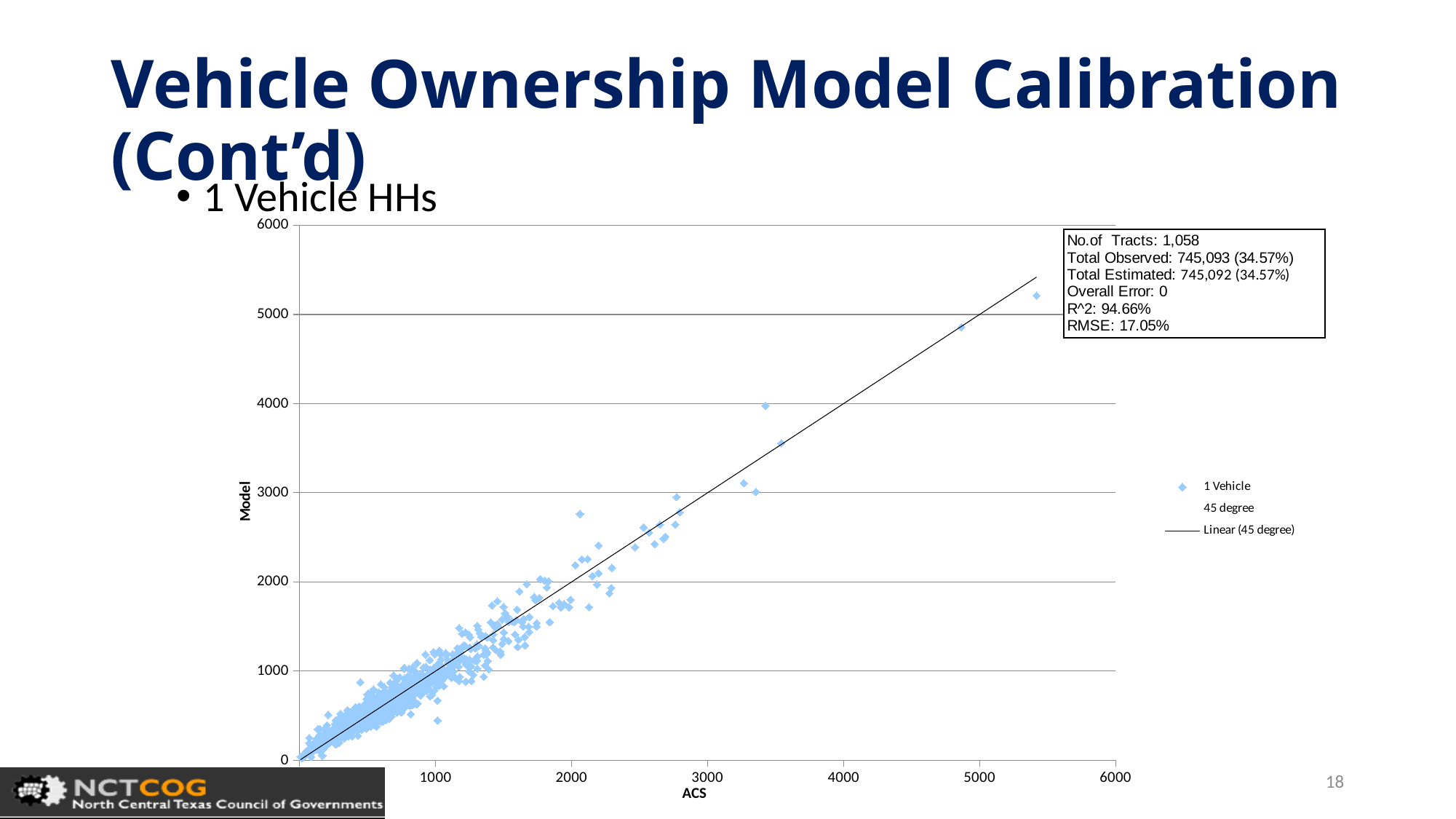
What Overall Error is reported in the chart's text box? 0 Is the Model value of the highest plotted point greater or less than 5000? greater Do the Model values generally rise or fall as the ACS values increase along the x axis? rise According to the text box on the chart, what is the Total Observed value? 745,093 (34.57%) What is the label of the y axis of the chart? Model According to the text box on the chart, what is the Total Estimated value? 745,092 (34.57%) What RMSE value is reported in the chart's text box? 17.05% How many entries does the chart legend list? 3 What is the label of the x axis of the chart? ACS What kind of chart is shown on the slide? scatter chart What R^2 value is reported in the chart's text box? 94.66% According to the text box on the chart, what is the number of tracts? 1,058